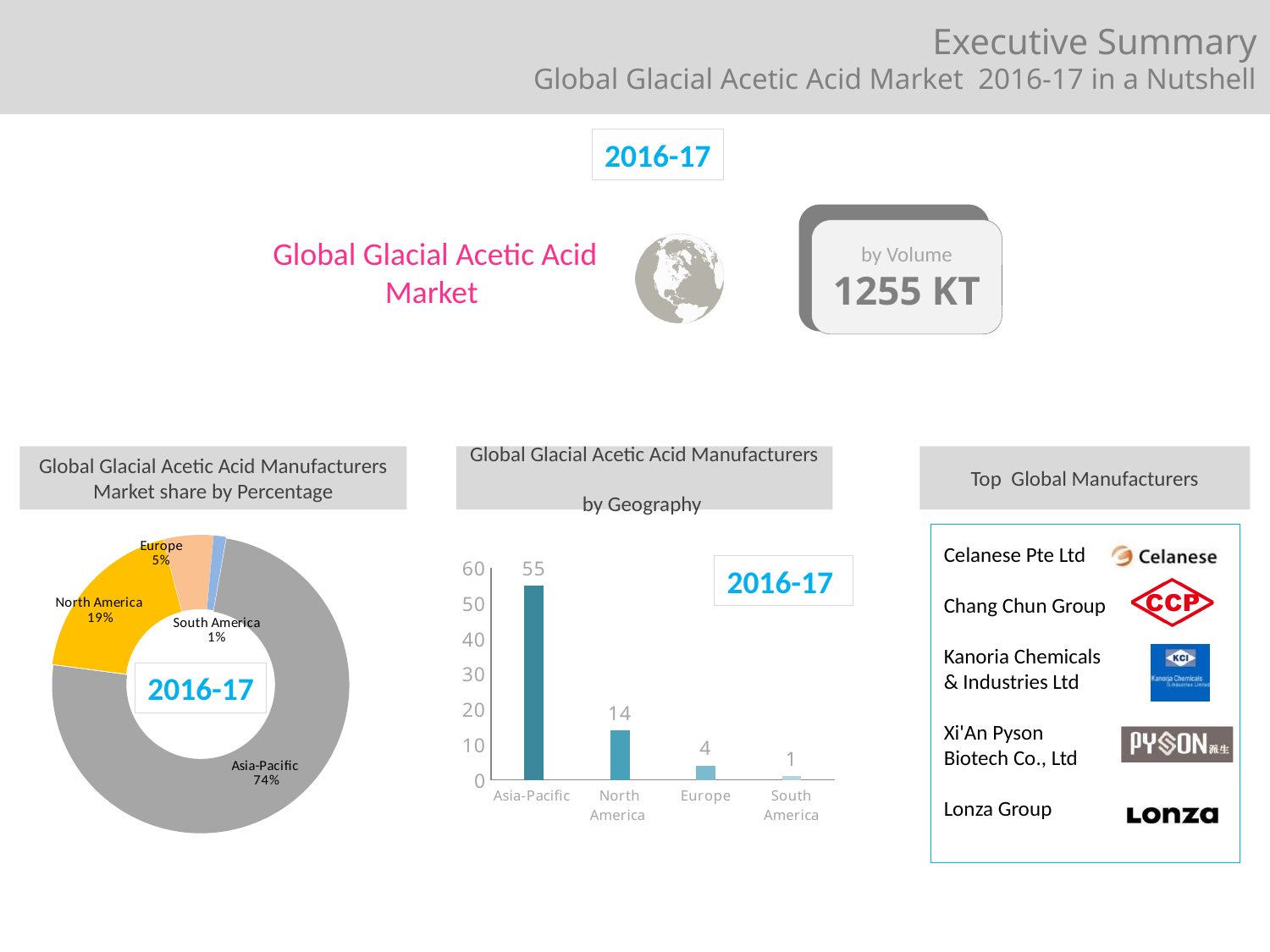
In the 'Global Glacial Acetic Acid Manufacturers Market share by Percentage' doughnut chart, what is the share for North America? 19% In the 'Global Glacial Acetic Acid Manufacturers Market share by Percentage' doughnut chart, which region has the smallest share? South America In the 'Global Glacial Acetic Acid Manufacturers by Geography' chart, do the values rise or fall from left to right along the x axis? Fall In the 'Global Glacial Acetic Acid Manufacturers Market share by Percentage' doughnut chart, what is the difference between the Europe and South America shares? 4% In the 'Global Glacial Acetic Acid Manufacturers by Geography' chart, which region has the highest value? Asia-Pacific What kind of chart is the 'Global Glacial Acetic Acid Manufacturers by Geography' chart? Bar chart In the 'Global Glacial Acetic Acid Manufacturers Market share by Percentage' doughnut chart, what is the share for Asia-Pacific? 74% In the 'Global Glacial Acetic Acid Manufacturers by Geography' chart, what is the value for Europe? 4 In the 'Global Glacial Acetic Acid Manufacturers by Geography' chart, which is larger, North America or Europe? North America In the 'Global Glacial Acetic Acid Manufacturers Market share by Percentage' doughnut chart, how many regions are shown? 4 In the 'Global Glacial Acetic Acid Manufacturers by Geography' chart, what is the difference between Asia-Pacific and North America? 41 In the 'Global Glacial Acetic Acid Manufacturers by Geography' chart, what is the value for Asia-Pacific? 55